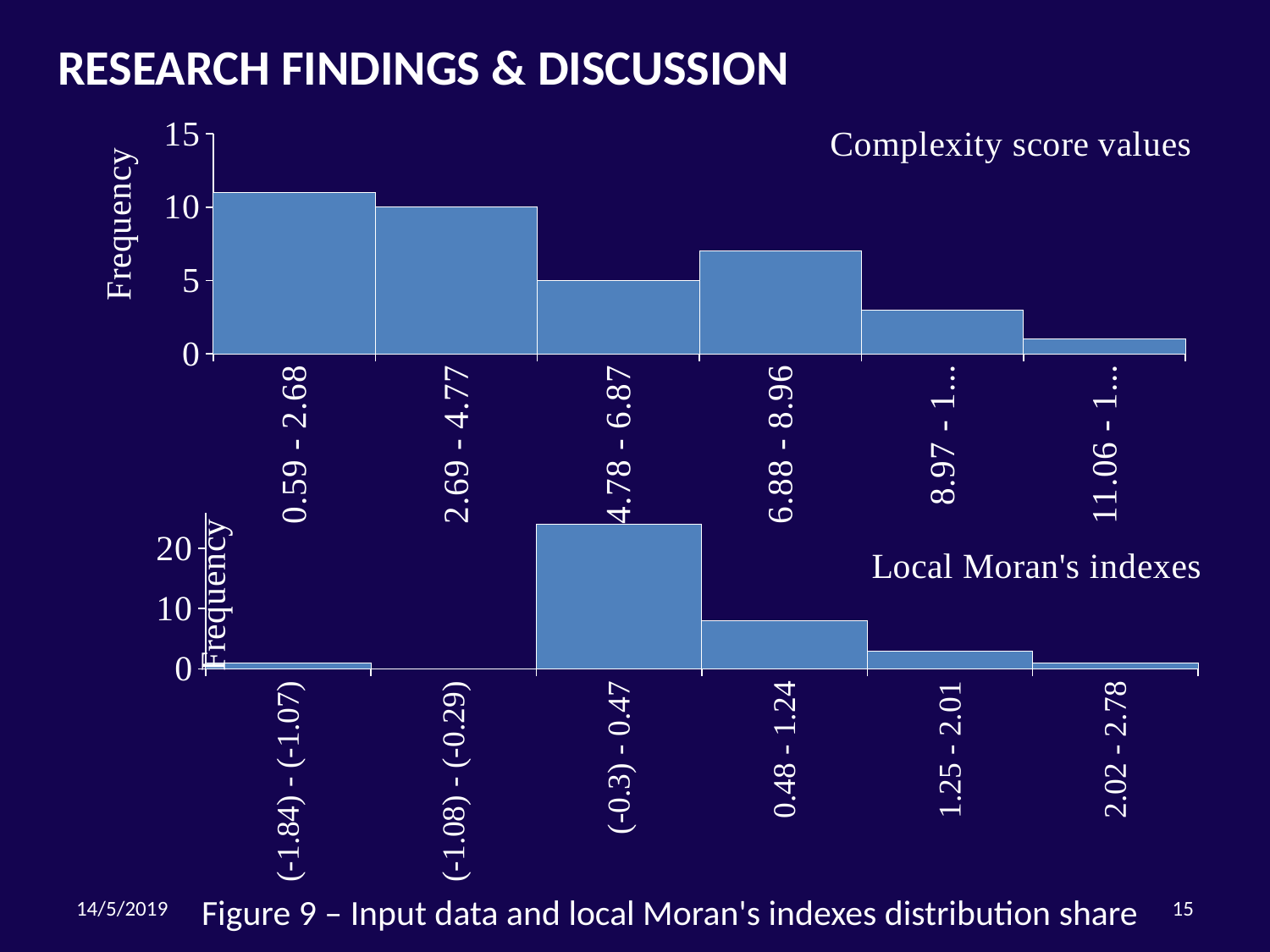
In the 'Local Moran's indexes' chart, which bin has the highest frequency? (-0.3) - 0.47 What kind of chart is the 'Complexity score values' chart? bar chart In the 'Complexity score values' chart, what is the frequency for the bin 4.78 - 6.87? 5 What kind of chart is the 'Local Moran's indexes' chart? bar chart In the 'Local Moran's indexes' chart, is the frequency for the bin (-0.3) - 0.47 greater or less than 20? greater In the 'Complexity score values' chart, which bin has the highest frequency? 0.59 - 2.68 In the 'Complexity score values' chart, is the frequency for the bin 6.88 - 8.96 greater or less than 5? greater In the 'Complexity score values' chart, which bin has the higher frequency, 0.59 - 2.68 or 6.88 - 8.96? 0.59 - 2.68 In the 'Complexity score values' chart, how many bins are shown on the x axis? 6 In the 'Complexity score values' chart, what is the frequency for the bin 2.69 - 4.77? 10 What is the label on the vertical axis of the 'Complexity score values' chart? Frequency In the 'Local Moran's indexes' chart, which bin has the higher frequency, 0.48 - 1.24 or 1.25 - 2.01? 0.48 - 1.24